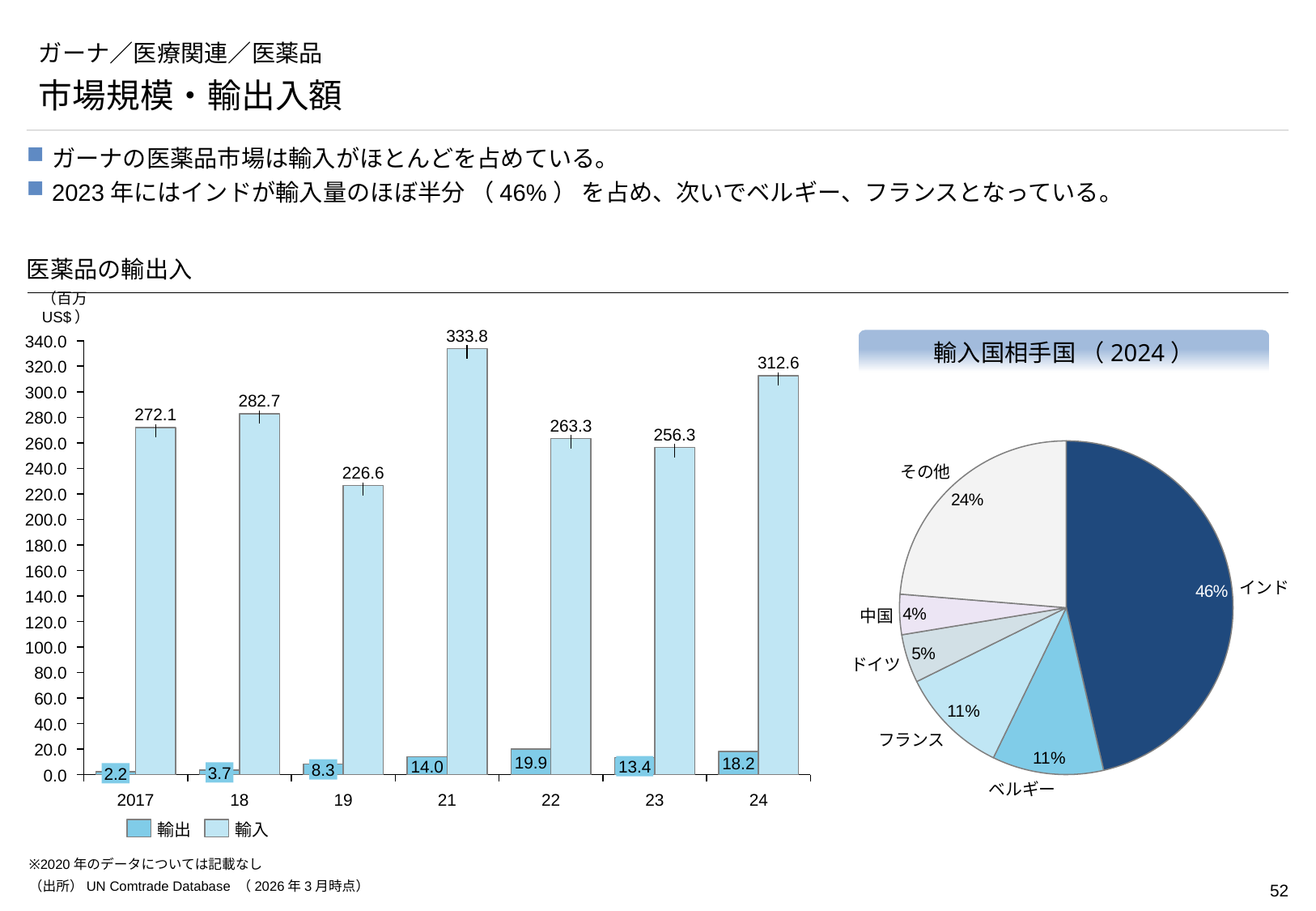
In the pie chart 輸入国相手国（2024）, what share does インド have? 46% What kind of chart is 医薬品の輸出入? bar chart In the bar chart 医薬品の輸出入, how many years are shown on the x axis? 7 In the bar chart 医薬品の輸出入, how many series does the legend list? 2 In the bar chart 医薬品の輸出入, which year has the highest 輸入 value? 21 In the bar chart 医薬品の輸出入, what is the value of 輸入 for 2017? 272.1 In the bar chart 医薬品の輸出入, what is the difference between the 輸入 values for 24 and 23? 56.3 In the bar chart 医薬品の輸出入, what is the value of 輸出 for 22? 19.9 In the bar chart 医薬品の輸出入, which is larger, the 輸入 value for 18 or for 19? 18 In the bar chart 医薬品の輸出入, which year has the lowest 輸出 value? 2017 In the pie chart 輸入国相手国（2024）, how many slices are there? 6 In the pie chart 輸入国相手国（2024）, which country has the smallest share? 中国